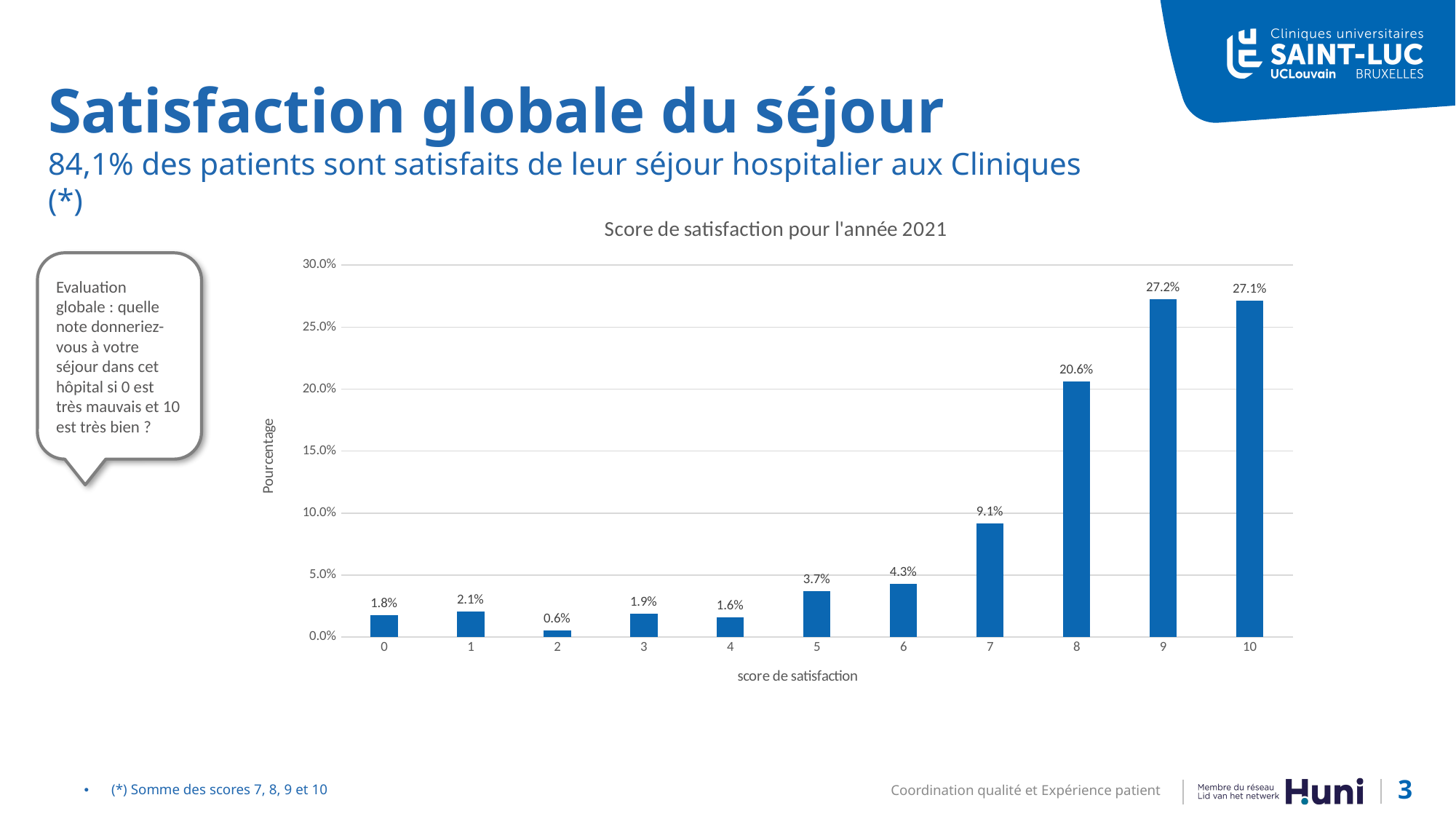
Is the value for satisfaction score 7 greater or less than 10.0%? less What percentage of patients gave a satisfaction score of 5? 3.7% What is the difference in percentage between satisfaction score 8 and satisfaction score 7? 11.5% What is the title of the chart? Score de satisfaction pour l'année 2021 What percentage of patients gave a satisfaction score of 2? 0.6% Which satisfaction score has the lowest percentage of patients? 2 How many satisfaction score categories are shown on the x axis? 11 What percentage of patients gave a satisfaction score of 9? 27.2% What percentage of patients gave a satisfaction score of 8? 20.6% Which has a higher percentage: satisfaction score 6 or satisfaction score 7? 7 What is the label of the y axis? Pourcentage What kind of chart is shown on the slide? bar chart